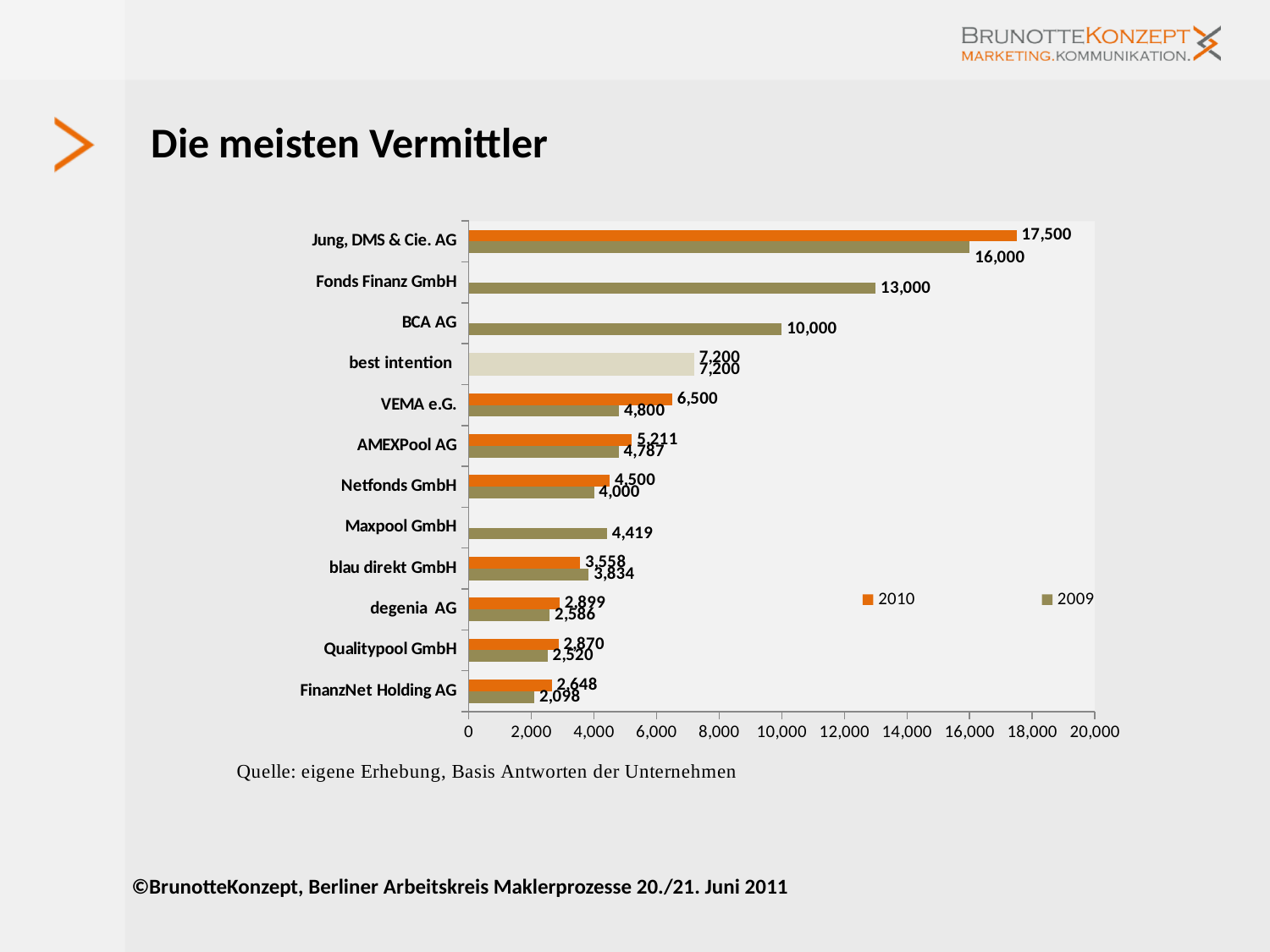
What kind of chart is shown on the slide? Bar chart What is the 2009 value for Maxpool GmbH? 4,419 Which company has the highest 2009 value? Jung, DMS & Cie. AG For blau direkt GmbH, which year has the larger value, 2010 or 2009? 2009 How many companies are listed on the chart? 12 What is the difference between the 2010 and 2009 values for Jung, DMS & Cie. AG? 1,500 What is the 2010 value for Jung, DMS & Cie. AG? 17,500 What is the 2009 value for BCA AG? 10,000 What is the 2009 value for Fonds Finanz GmbH? 13,000 How many series does the legend list? 2 What is the difference between the 2010 and 2009 values for VEMA e.G.? 1,700 Which company has the lowest 2009 value? FinanzNet Holding AG